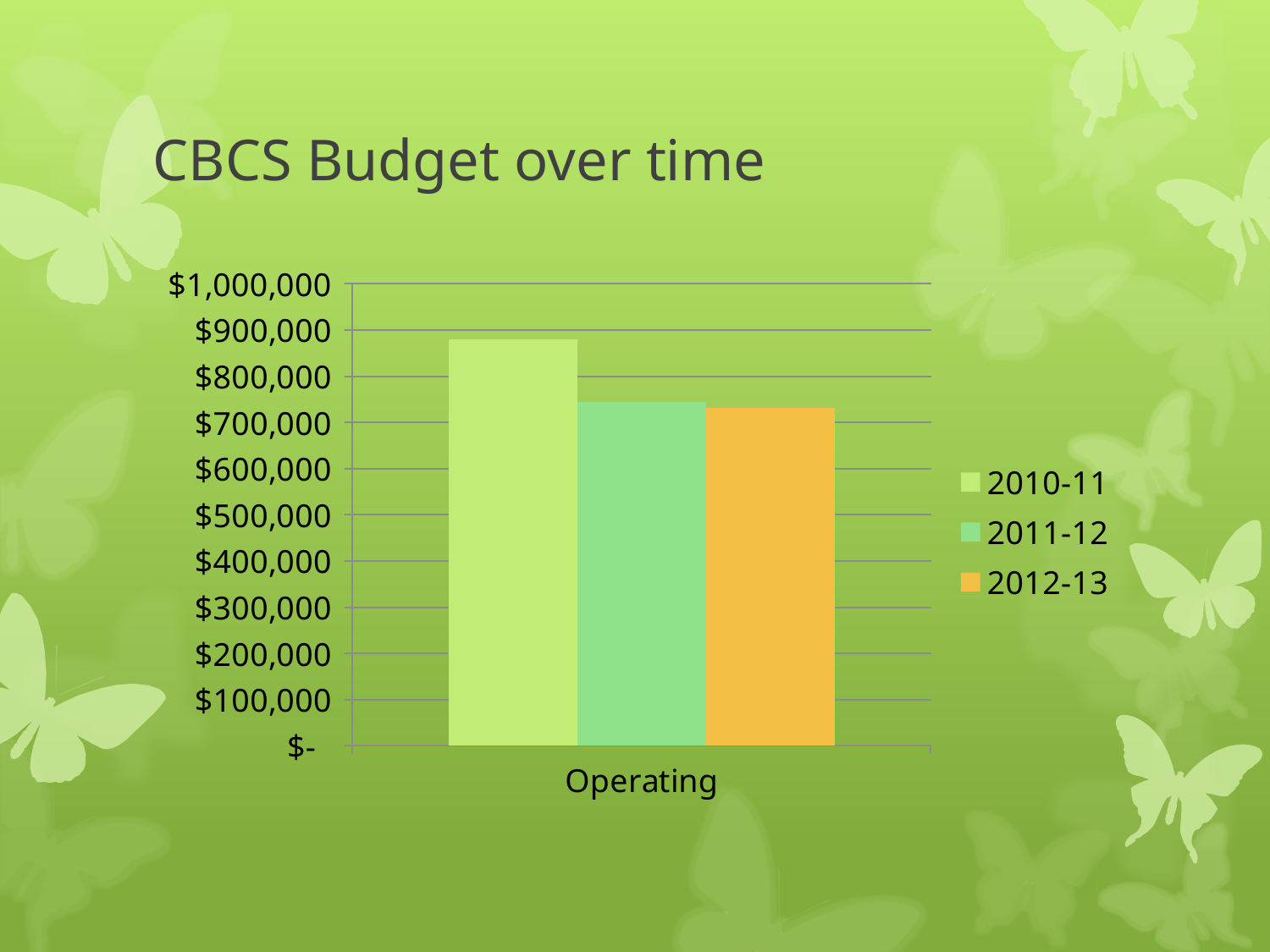
What kind of chart is shown on the slide? bar chart Is the Operating value for 2011-12 greater or less than $700,000? greater What is the category label on the x axis? Operating How many categories are shown on the x axis? 1 Is the Operating value for 2012-13 greater or less than $700,000? greater What is the title of the chart on the slide? CBCS Budget over time Which is larger, the Operating value for 2010-11 or for 2012-13? 2010-11 Is the Operating value for 2010-11 greater or less than $800,000? greater Does the Operating budget rise or fall from 2010-11 to 2012-13? fall How many series does the legend list? 3 Which year has the highest Operating budget? 2010-11